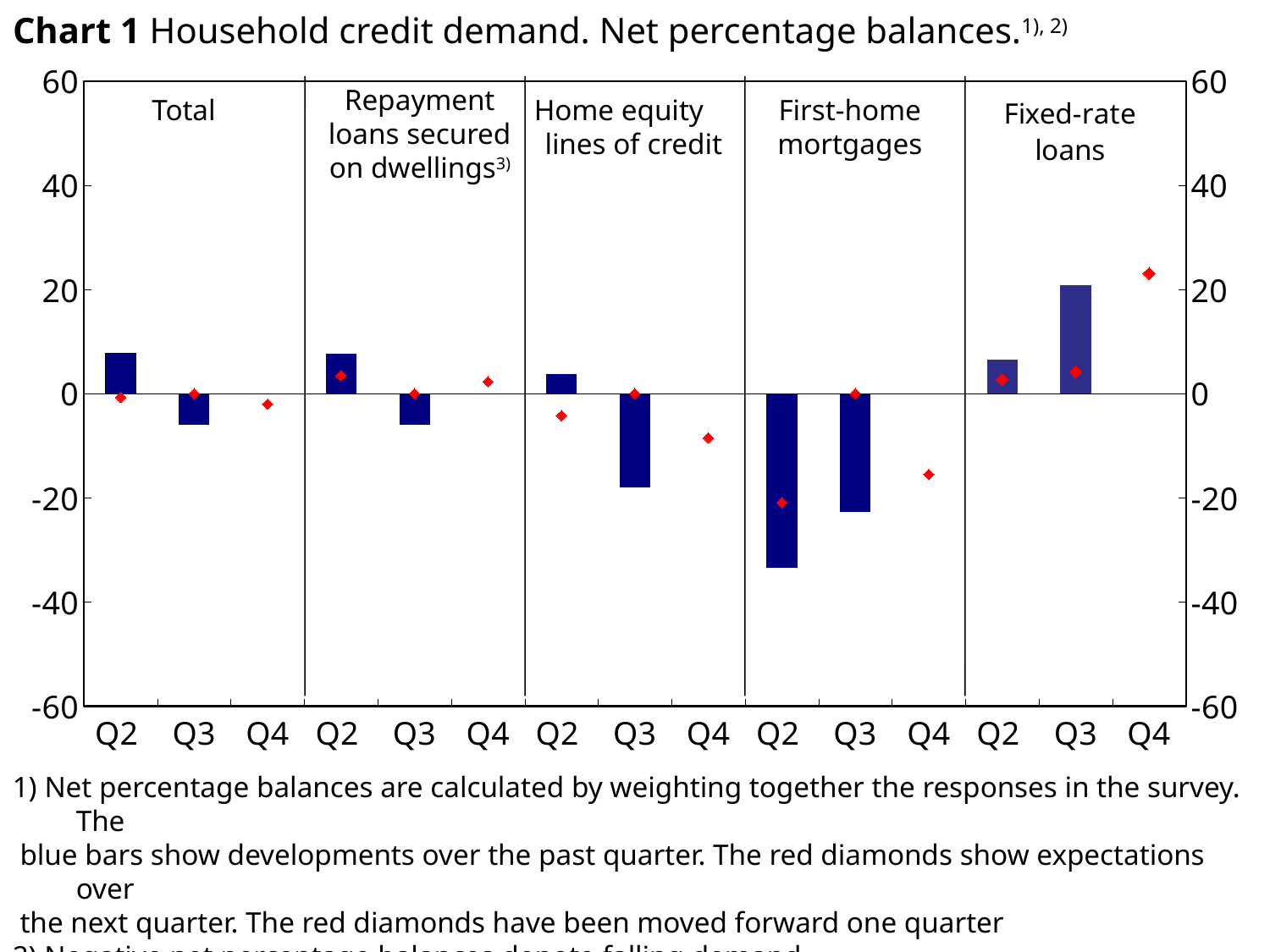
For Fixed-rate loans, which bar is higher, Q2 or Q3? Q3 For First-home mortgages, which bar is higher, Q2 or Q3? Q3 How many credit categories (panels) are shown in Chart 1? 5 Do the bars for Fixed-rate loans rise or fall from Q2 to Q3? rise According to the footnote, what do the red diamonds show? expectations over the next quarter Is the Q3 bar for Home equity lines of credit greater or less than -10? less Is the Q2 bar for First-home mortgages greater or less than -20? less Is the Q4 red diamond for Fixed-rate loans greater or less than 20? greater Which category has the lowest bar in Chart 1? First-home mortgages Which category has the highest bar in Chart 1? Fixed-rate loans What kind of chart is Chart 1? bar chart